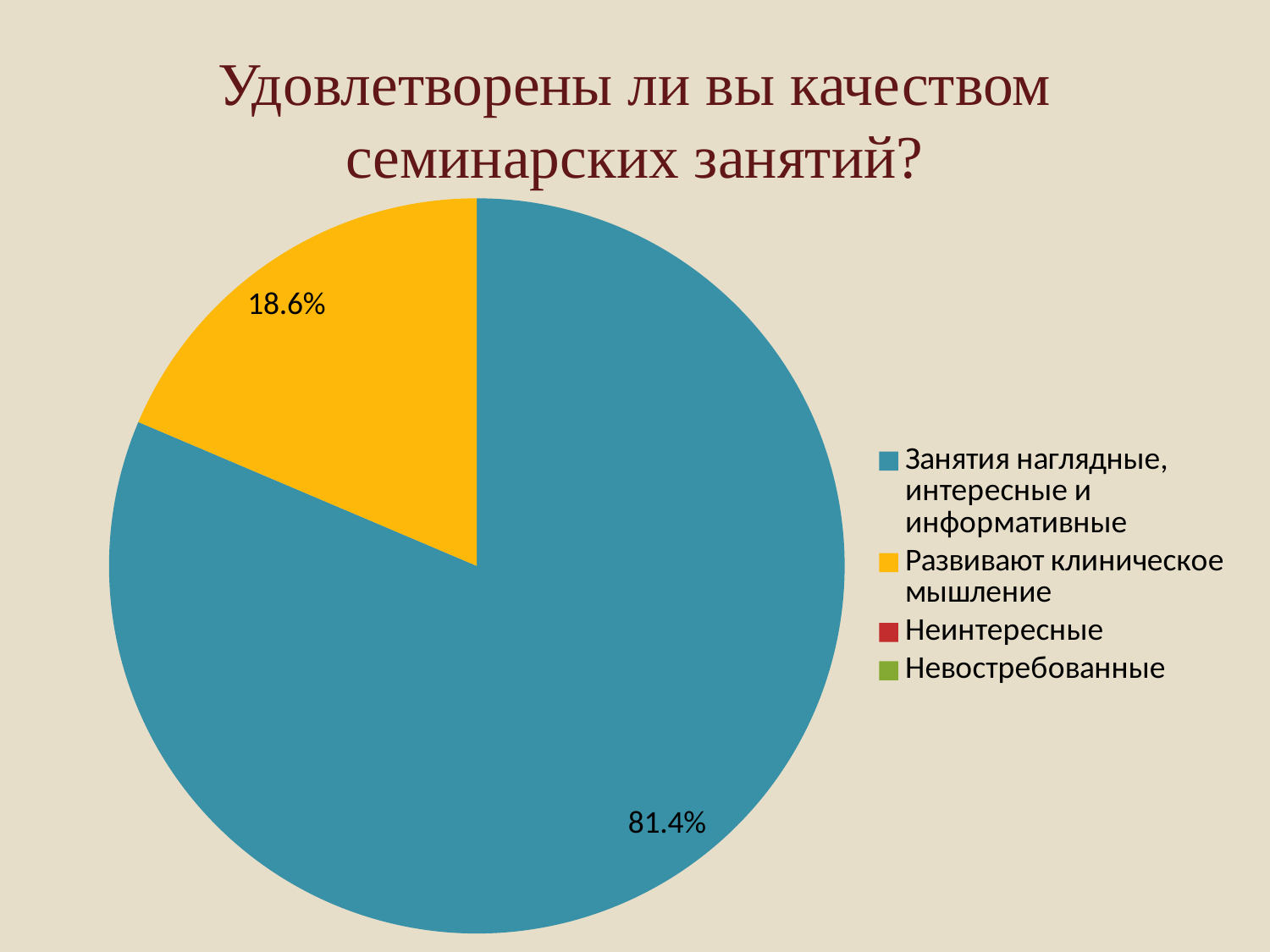
Which category has the largest slice of the pie? Занятия наглядные, интересные и информативные How many entries does the legend list? 4 What is the title of the chart? Удовлетворены ли вы качеством семинарских занятий? What share of the pie does the yellow slice represent? 18.6% What is the difference in percentage points between the 81.4% slice and the 18.6% slice? 62.8 What colour is the legend marker for "Неинтересные"? red What percentage is shown for "Развивают клиническое мышление"? 18.6% Which of the two labelled slices is the smaller one? Развивают клиническое мышление How many slices are visibly drawn in the pie? 2 What percentage is shown for "Занятия наглядные, интересные и информативные"? 81.4% What kind of chart is shown on the slide? pie chart Which is larger: the share for "Развивают клиническое мышление" or the share for "Занятия наглядные, интересные и информативные"? Занятия наглядные, интересные и информативные